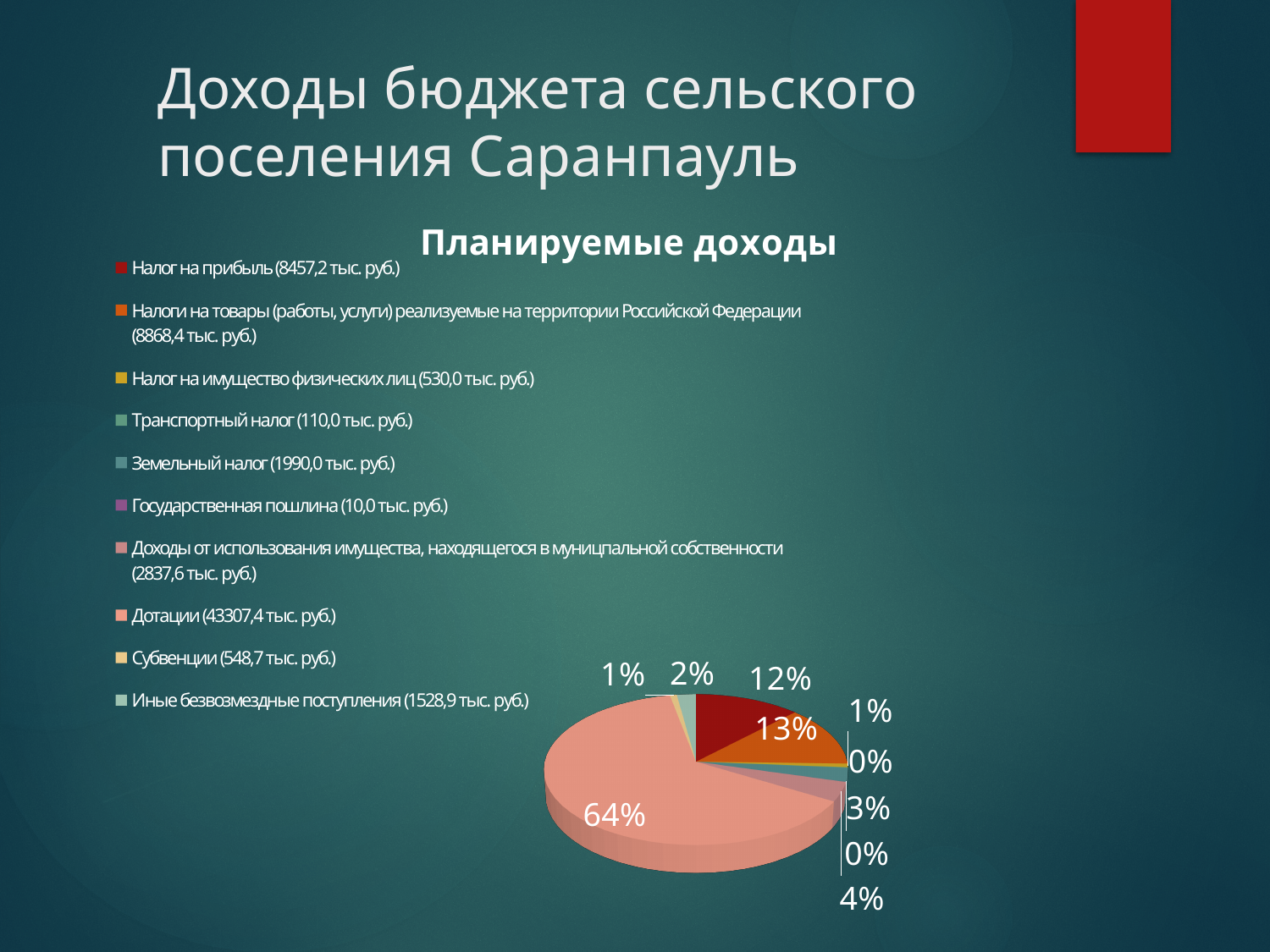
What type of chart is shown on the slide? pie chart How many categories does the legend of the pie chart list? 10 What share of the pie does Налоги на товары (работы, услуги) реализуемые на территории Российской Федерации take? 13% What share of the pie does Налог на прибыль take? 12% What share of the pie does Доходы от использования имущества, находящегося в муниципальной собственности take? 4% Which is larger: the slice for Налог на прибыль or the slice for Дотации? Дотации Which category has the smallest planned amount according to the legend? Государственная пошлина Which category has the largest slice of the pie? Дотации What is the title of the chart? Планируемые доходы What planned amount is given for Дотации in the legend? 43307,4 тыс. руб.